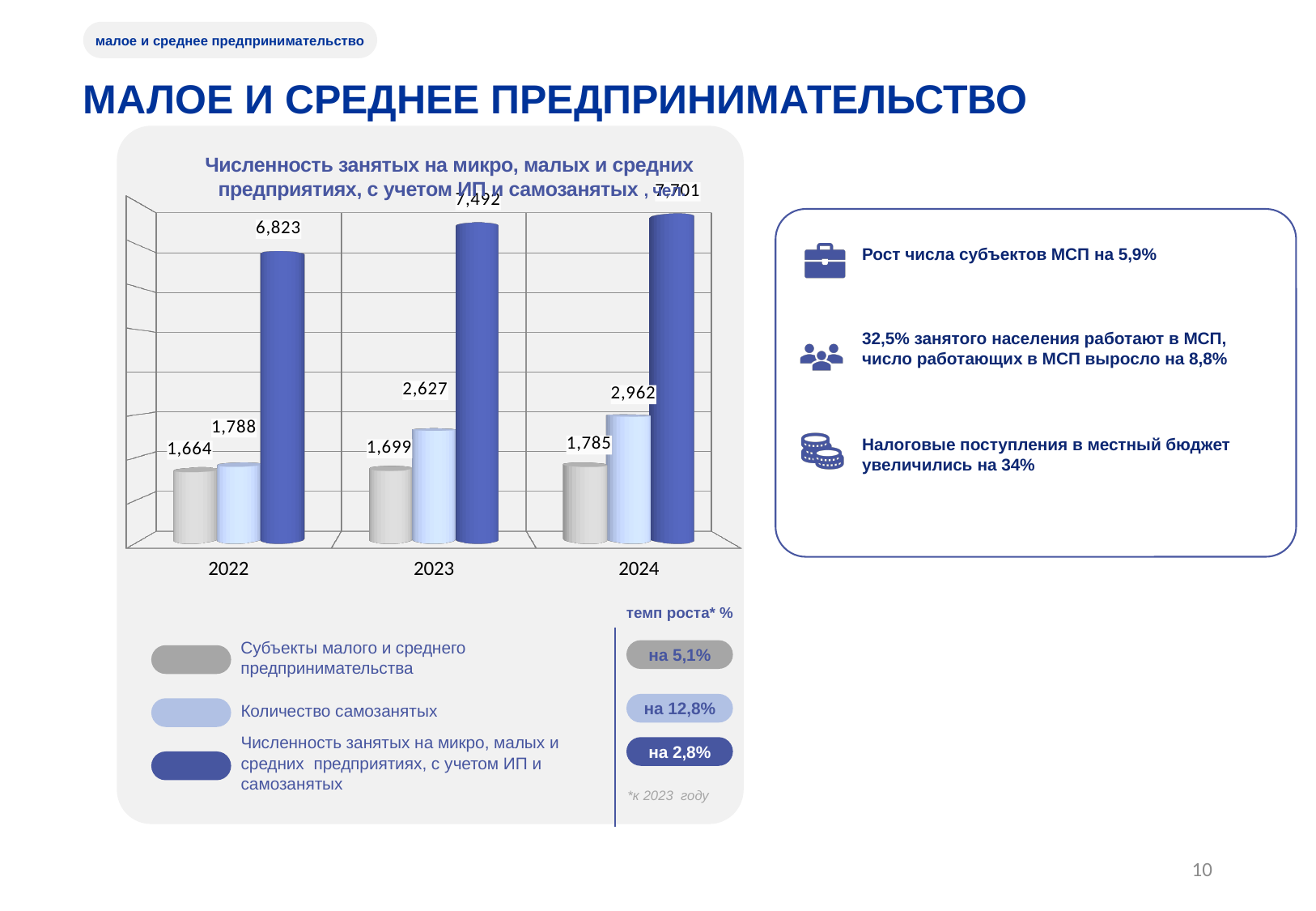
Сколько лет (категорий) показано на оси X диаграммы? 3 Какого типа эта диаграмма? Столбчатая (bar chart) Сколько субъектов малого и среднего предпринимательства показано на диаграмме за 2022 год? 1,664 Какое значение показателя «Количество самозанятых» в 2023 году? 2,627 Что больше: количество самозанятых в 2022 году или число субъектов малого и среднего предпринимательства в 2024 году? Количество самозанятых в 2022 году (1,788) На сколько выросло количество самозанятых с 2022 по 2024 год? 1,174 В каком году численность занятых на микро, малых и средних предприятиях (с учетом ИП и самозанятых) была наименьшей? 2022 Сколько рядов данных перечислено в легенде диаграммы? 3 Какова разница между численностью занятых (с учетом ИП и самозанятых) в 2023 и 2022 годах? 669 Как меняется число субъектов малого и среднего предпринимательства с 2022 по 2024 год — растет или падает? Растет Какова численность занятых на микро, малых и средних предприятиях, с учетом ИП и самозанятых, в 2024 году? 7,701 В каком году количество самозанятых было наибольшим? 2024